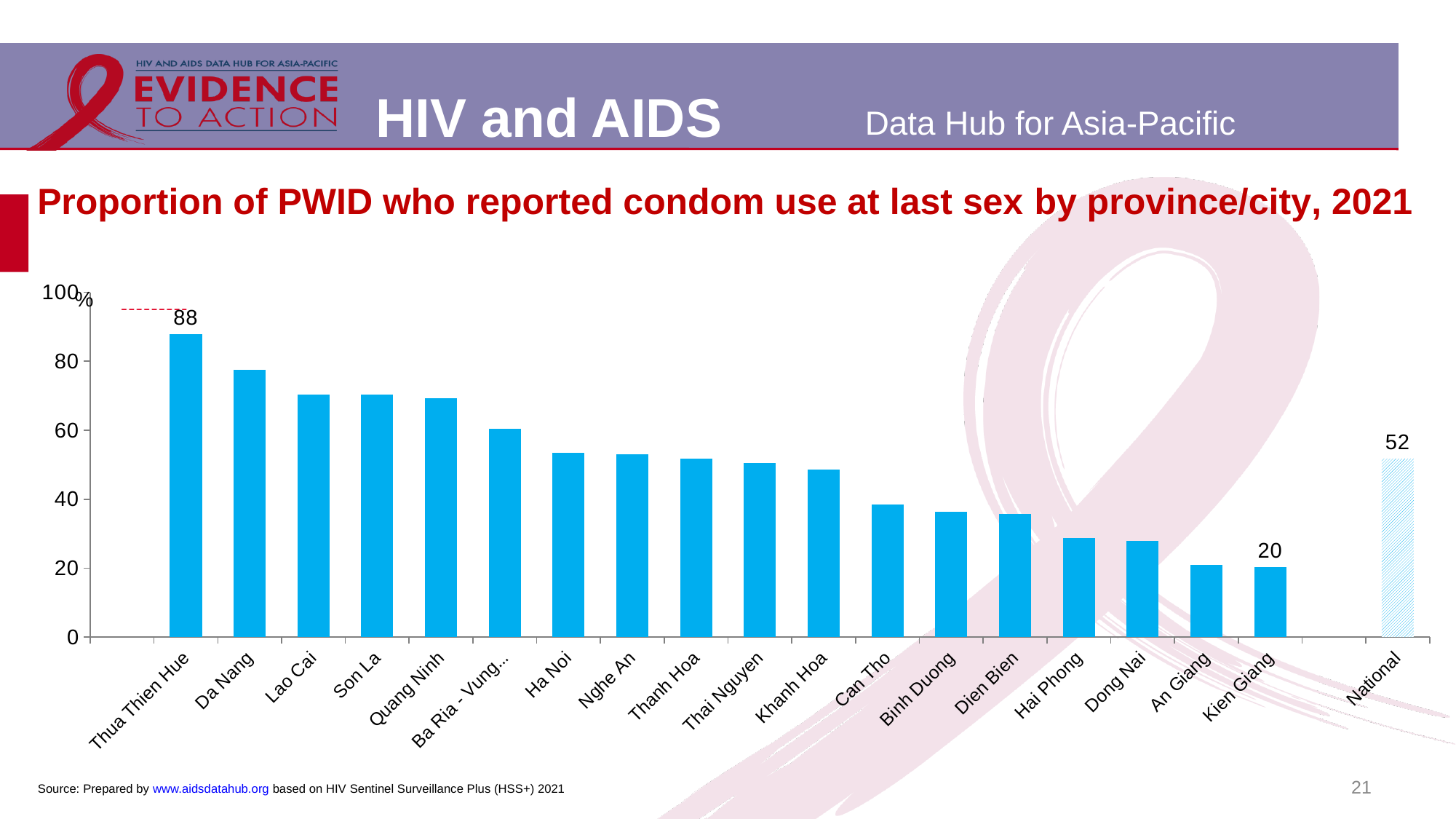
What kind of chart is shown on the slide? Bar chart What is the value for Thua Thien Hue? 88 Is the value for Da Nang greater or less than 80? less What is the difference between the values for Thua Thien Hue and Kien Giang? 68 Which has a larger value, Da Nang or Ha Noi? Da Nang Is the value for Hai Phong greater or less than 20? greater How much higher is the value for Thua Thien Hue than the National value? 36 Which province/city has the highest proportion? Thua Thien Hue How many provinces/cities are shown on the chart, not counting the National bar? 18 What is the National value shown on the chart? 52 What is the value for Kien Giang? 20 Do the province/city values rise or fall from left to right along the x axis? Fall